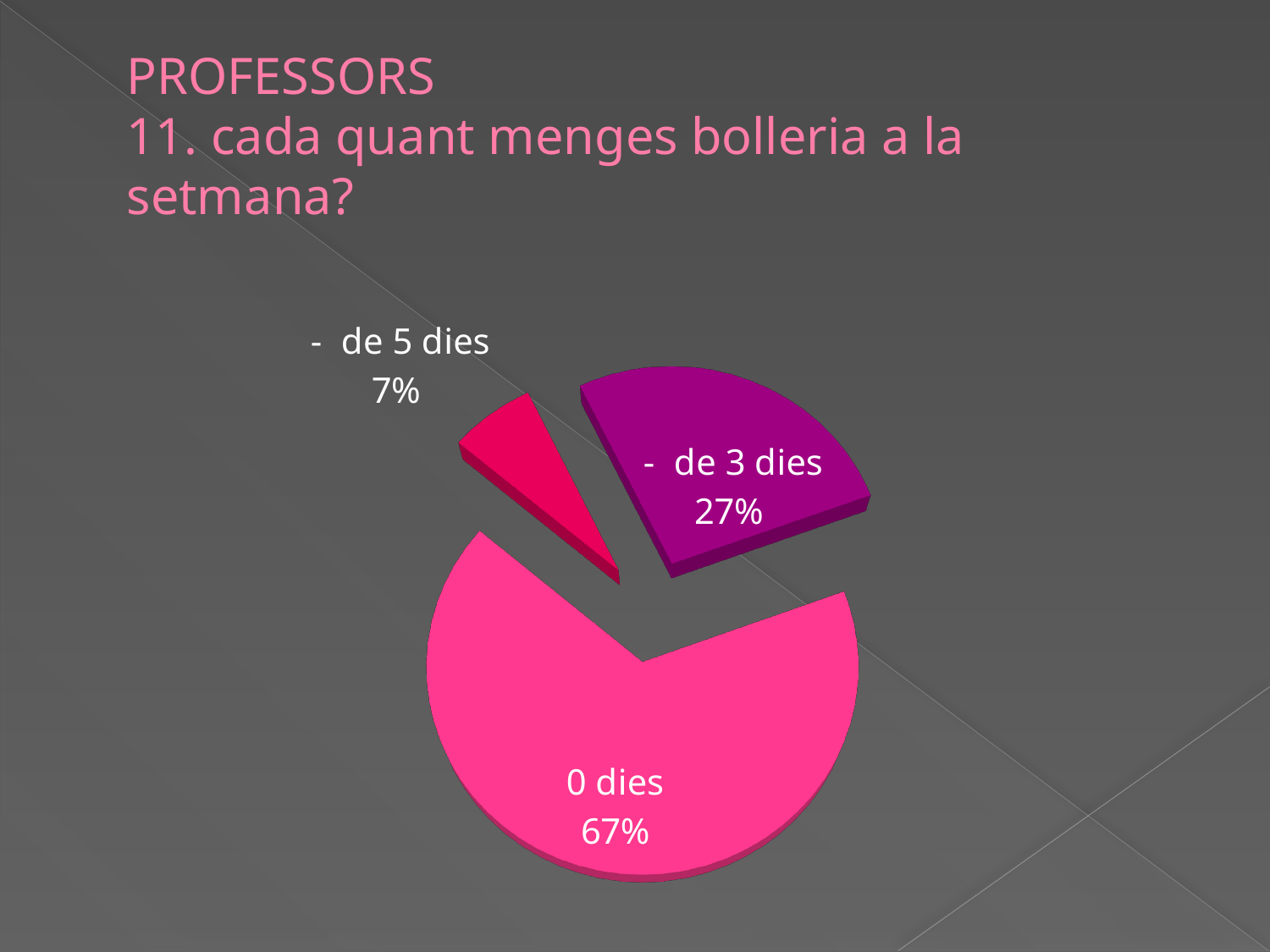
Which is larger, the "- de 3 dies" slice or the "- de 5 dies" slice? - de 3 dies What question does the slide title say the chart answers? 11. cada quant menges bolleria a la setmana? What is the difference in percentage points between the "- de 3 dies" slice and the "- de 5 dies" slice? 20 How many slices does the pie chart have? 3 What colour is the "- de 3 dies" slice? purple What is the difference in percentage points between the "0 dies" slice and the "- de 3 dies" slice? 40 What kind of chart is shown on the slide? pie chart What share of the pie does the "0 dies" slice represent? 67% Which category has the largest slice of the pie? 0 dies What share of the pie does the "- de 3 dies" slice represent? 27% Which category has the smallest slice of the pie? - de 5 dies What share of the pie does the "- de 5 dies" slice represent? 7%